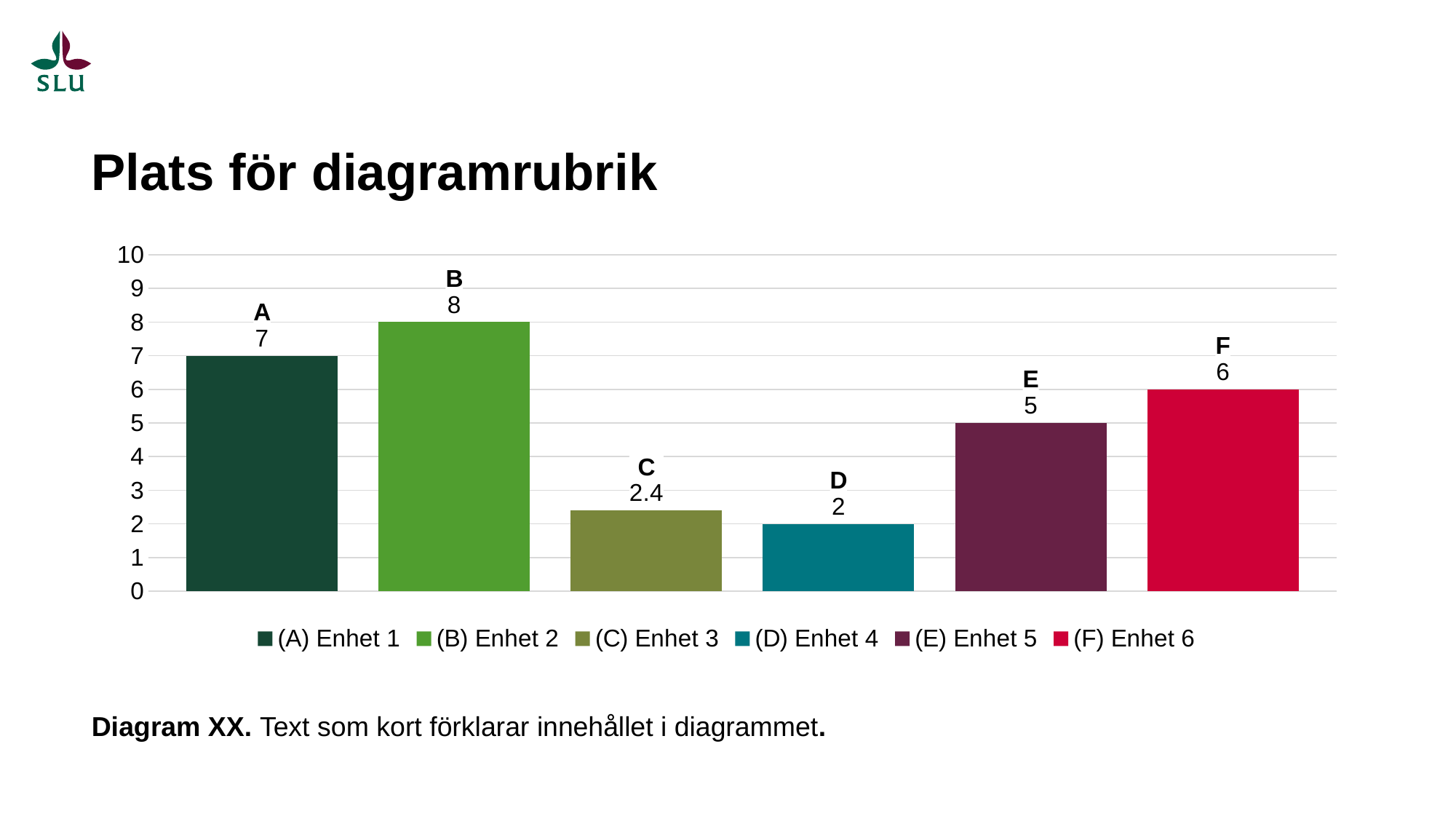
What is the difference between the values for (C) Enhet 3 and (D) Enhet 4? 0.4 Is the value for (E) Enhet 5 greater or less than 4? greater Which is larger, the value for (A) Enhet 1 or the value for (F) Enhet 6? (A) Enhet 1 What is the title shown above the chart? Plats för diagramrubrik What is the value for (B) Enhet 2? 8 How many bars are plotted in the chart? 6 What kind of chart is shown on the slide? bar chart Which category has the highest value? (B) Enhet 2 What is the difference between the values for (A) Enhet 1 and (E) Enhet 5? 2 What is the value for (F) Enhet 6? 6 What is the value for (C) Enhet 3? 2.4 Which category has the lowest value? (D) Enhet 4